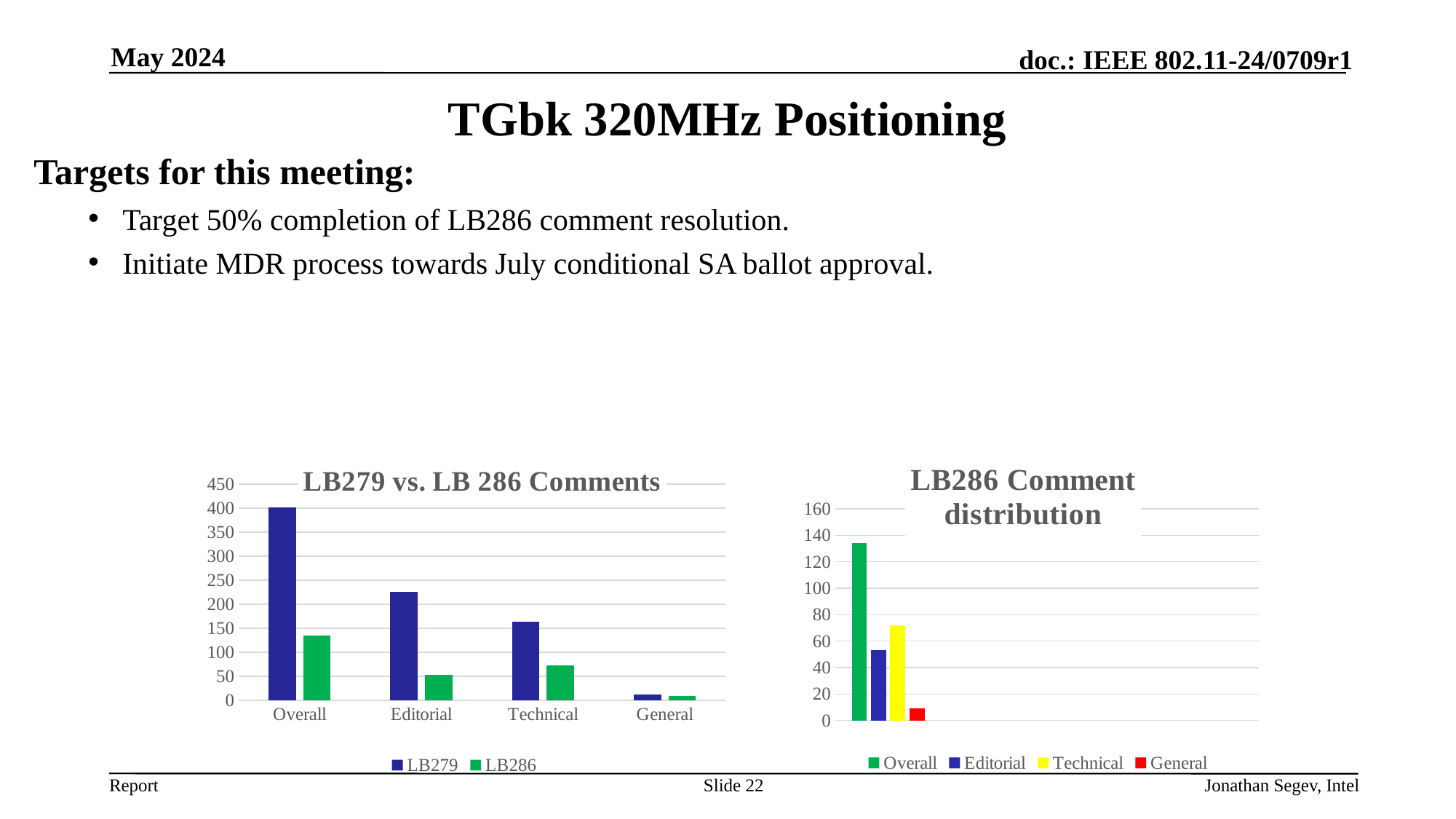
In the 'LB286 Comment distribution' chart, is the value for General greater or less than 20? less In the 'LB279 vs. LB 286 Comments' chart, which category has the lowest LB286 value? General In the 'LB279 vs. LB 286 Comments' chart, is the LB279 value for Editorial greater or less than 200? greater In the 'LB286 Comment distribution' chart, which is larger: Editorial or Technical? Technical In the 'LB286 Comment distribution' chart, which category has the highest value? Overall In the 'LB279 vs. LB 286 Comments' chart, is the LB286 value for Overall greater or less than 100? greater In the 'LB279 vs. LB 286 Comments' chart, which category has the highest LB279 value? Overall What kind of chart is the 'LB279 vs. LB 286 Comments' chart? bar chart In the 'LB279 vs. LB 286 Comments' chart, which is larger for Editorial: LB279 or LB286? LB279 How many categories are shown on the x axis of the 'LB279 vs. LB 286 Comments' chart? 4 How many series does the legend of the 'LB279 vs. LB 286 Comments' chart list? 2